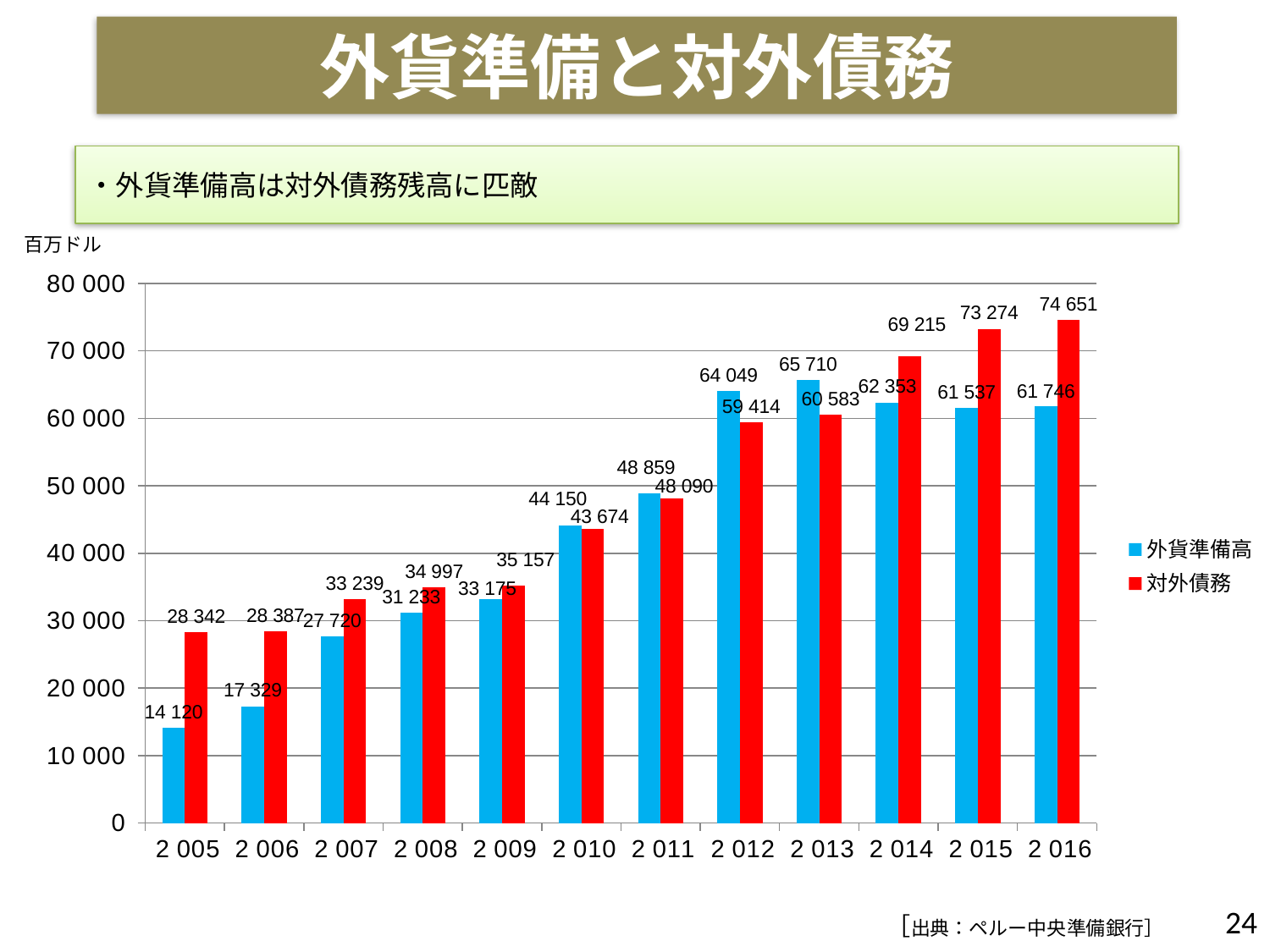
What is the value of 外貨準備高 for 2 012? 64 049 In which year is 外貨準備高 highest? 2 013 In which year is 対外債務 lowest? 2 005 What is the value of 対外債務 for 2 016? 74 651 Does 対外債務 generally rise or fall from 2 005 to 2 016? rise What is the difference between 対外債務 and 外貨準備高 in 2 016? 12 905 What is the value of 外貨準備高 for 2 005? 14 120 What kind of chart is shown on the slide? bar chart Is the value of 対外債務 for 2 015 greater or less than 70 000? greater Which is larger in 2 013, 外貨準備高 or 対外債務? 外貨準備高 How many years are shown on the x axis? 12 How many series does the legend list? 2